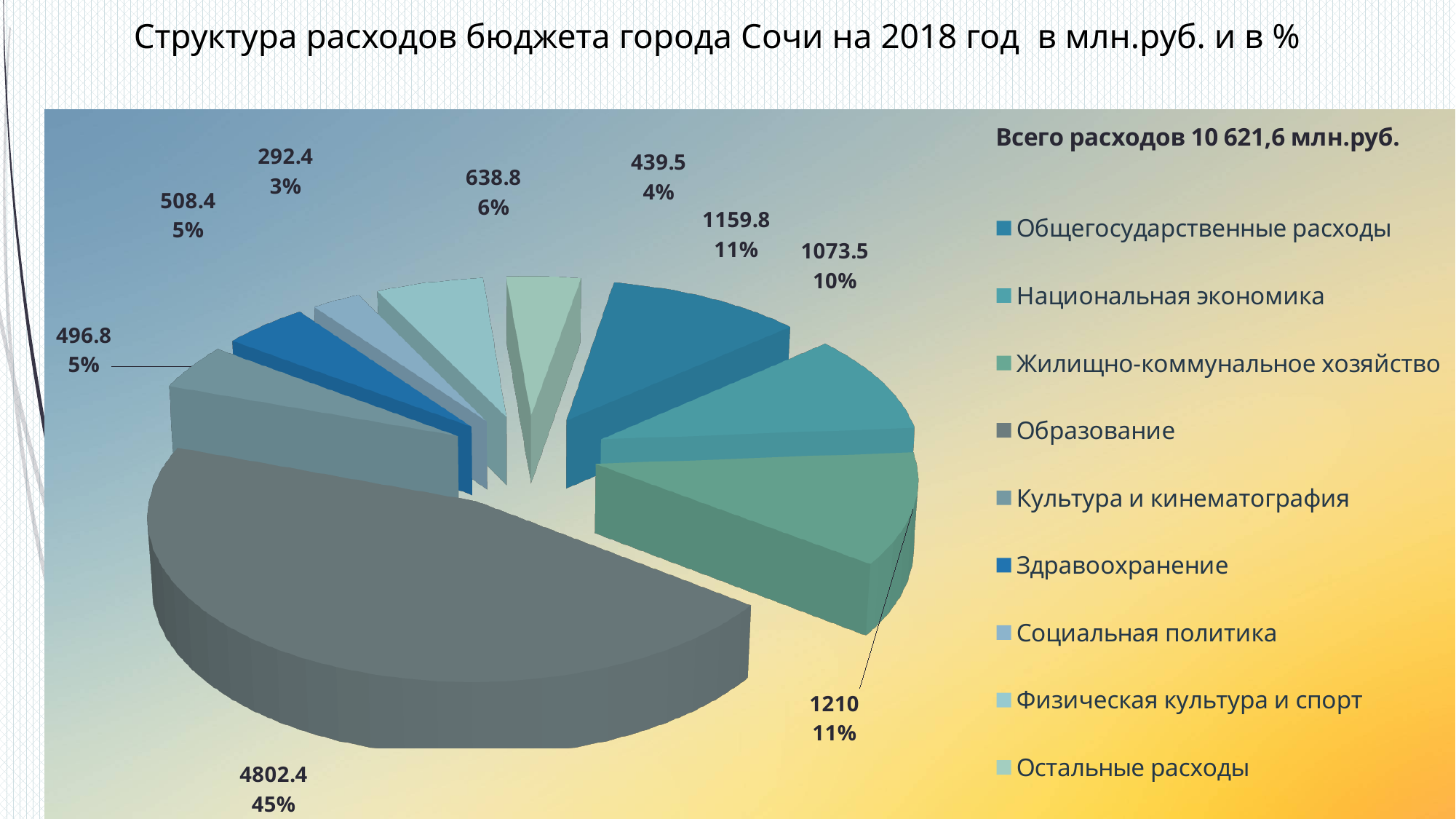
How many expenditure categories does the legend list? 9 Which category has the largest share of the budget expenditures? Образование What is the value shown for Жилищно-коммунальное хозяйство? 1210 What type of chart is shown on the slide? pie chart What share of total expenditures does Образование account for? 45% Which is larger, Общегосударственные расходы or Национальная экономика? Общегосударственные расходы What is the difference between the values for Образование and Жилищно-коммунальное хозяйство? 3592.4 What is the title of the slide? Структура расходов бюджета города Сочи на 2018 год в млн.руб. и в % What is the smallest value labelled on the pie chart? 292.4 What is the value shown for Образование? 4802.4 What share of expenditures does Здравоохранение account for? 5% What is the total expenditure stated on the slide? 10 621,6 млн.руб.